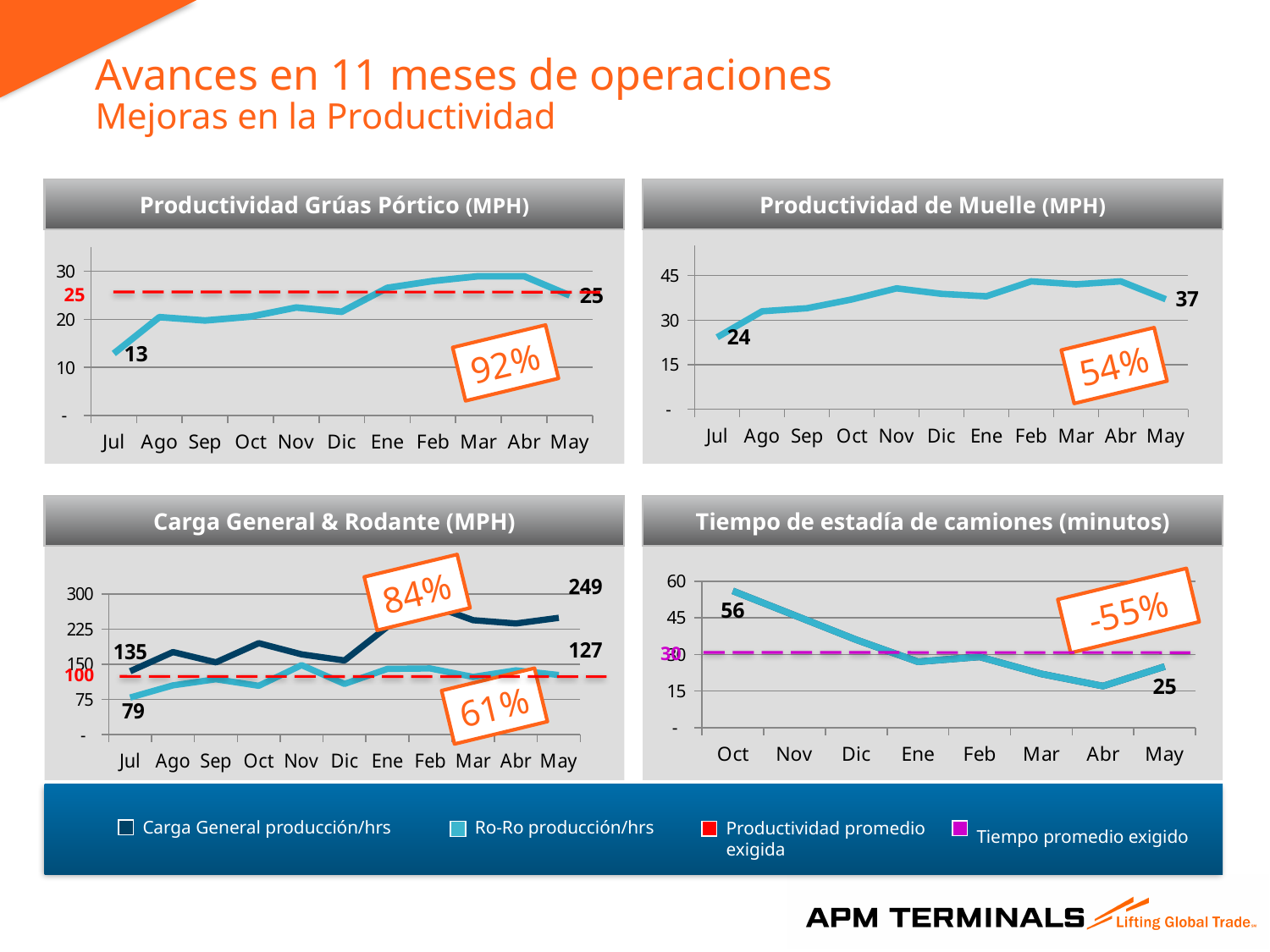
In the 'Productividad de Muelle (MPH)' chart, what is the value for Jul? 24 In the 'Tiempo de estadía de camiones (minutos)' chart, what is the value for Oct? 56 In the 'Carga General & Rodante (MPH)' chart, what is the Ro-Ro producción/hrs value for Jul? 79 In the 'Tiempo de estadía de camiones (minutos)' chart, do the values generally rise or fall from Oct to May? fall In the 'Tiempo de estadía de camiones (minutos)' chart, how many months are shown on the x axis? 8 In the 'Carga General & Rodante (MPH)' chart, which series has the higher value in May, Carga General producción/hrs or Ro-Ro producción/hrs? Carga General producción/hrs In the 'Productividad Grúas Pórtico (MPH)' chart, what is the value for May? 25 In the 'Productividad de Muelle (MPH)' chart, what is the difference between the May value and the Jul value? 13 What kind of chart is 'Productividad Grúas Pórtico (MPH)'? line chart In the 'Productividad de Muelle (MPH)' chart, is the value for Feb greater or less than 30? greater In the 'Carga General & Rodante (MPH)' chart, what is the Carga General producción/hrs value for May? 249 In the 'Productividad Grúas Pórtico (MPH)' chart, what is the value for Jul? 13